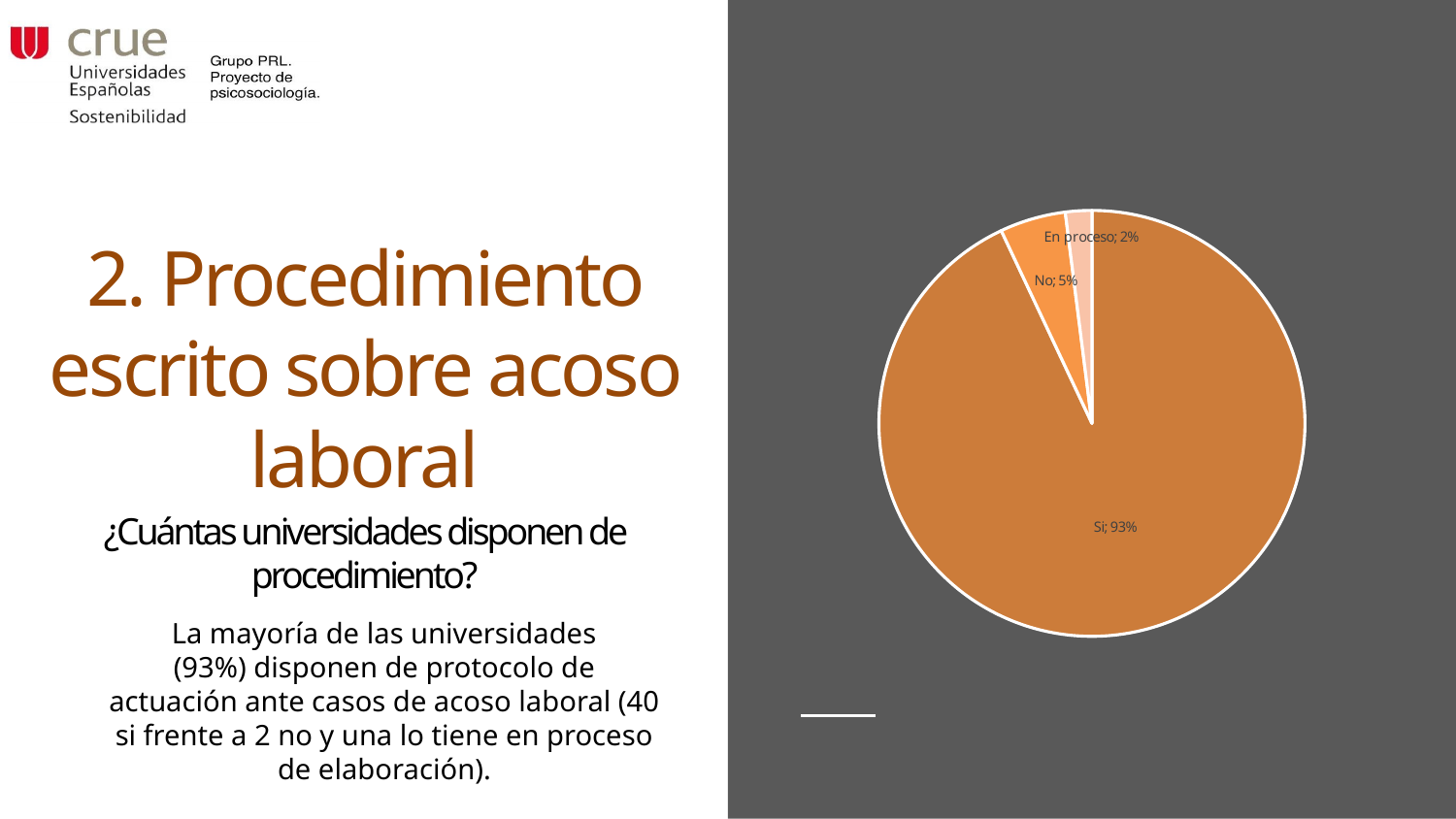
What percentage of the pie chart is labelled "No"? 5% Which slice of the pie chart is the largest? Si What is the combined percentage of the "No" and "En proceso" slices? 7% What kind of chart is shown on the slide? pie chart How many slices does the pie chart have? 3 Which slice is larger, "No" or "En proceso"? No What share of the pie does the "Si" slice represent? 93% What is the difference in percentage points between the "Si" slice and the "No" slice? 88 What percentage of the pie chart is labelled "En proceso"? 2% Which slice of the pie chart is the smallest? En proceso What is the difference in percentage points between the "No" slice and the "En proceso" slice? 3 What percentage of the pie chart is labelled "Si"? 93%